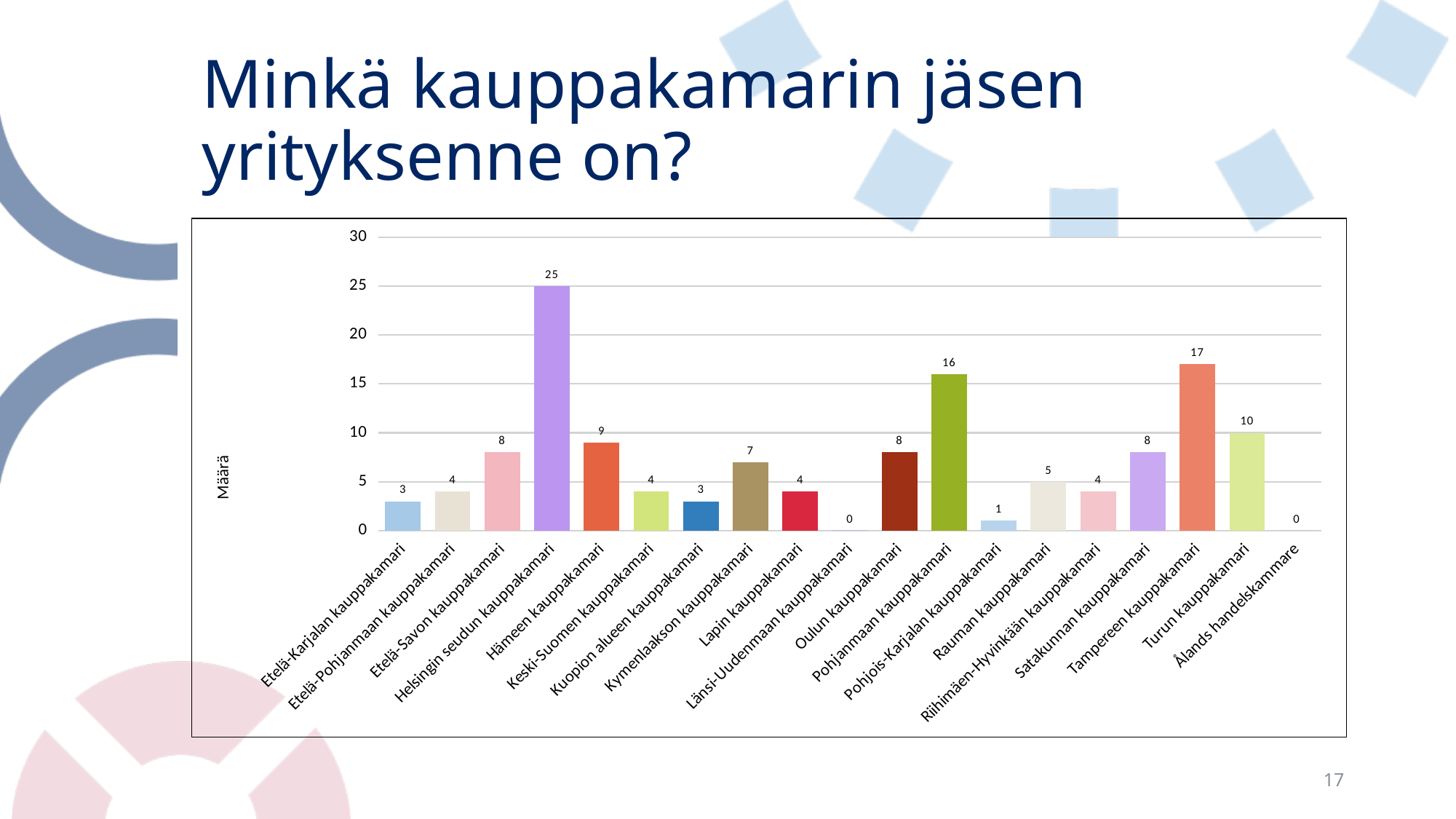
What is the value for Kymenlaakson kauppakamari? 7 Which is larger, the value for Hämeen kauppakamari or the value for Rauman kauppakamari? Hämeen kauppakamari What is the difference between the values for Pohjanmaan kauppakamari and Turun kauppakamari? 6 What is the difference between the values for Helsingin seudun kauppakamari and Tampereen kauppakamari? 8 Which category has the highest value? Helsingin seudun kauppakamari What kind of chart is shown on the slide? Bar chart How many categories are shown on the x axis? 19 What is the value for Tampereen kauppakamari? 17 What is the value for Pohjois-Karjalan kauppakamari? 1 What is the value for Helsingin seudun kauppakamari? 25 Is the value for Pohjanmaan kauppakamari greater or less than 10? greater What is the label on the vertical axis? Määrä